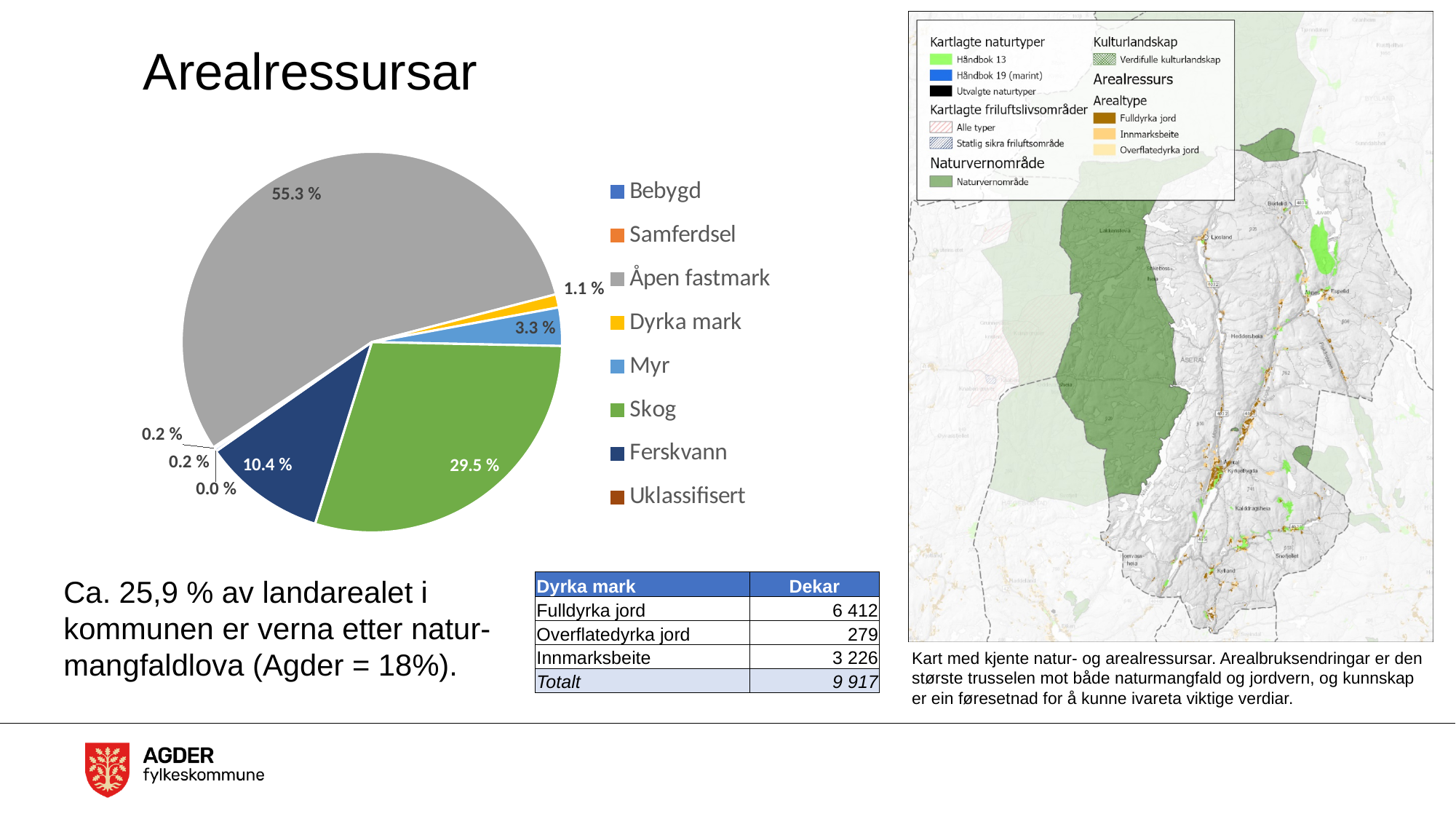
What share of the pie does Dyrka mark have? 1.1 % Which category has the largest slice of the pie? Åpen fastmark Which is larger, the share for Myr or the share for Dyrka mark? Myr What share of the pie does Ferskvann have? 10.4 % What is the difference in percentage points between Skog and Ferskvann? 19.1 % What kind of chart is shown on the slide? pie chart How many categories does the legend of the pie chart list? 8 What share of the pie does Åpen fastmark have? 55.3 % What share of the pie does Myr have? 3.3 % What colour is the Skog slice in the pie chart? green Which category has the smallest slice of the pie? Uklassifisert What share of the pie does Skog have? 29.5 %